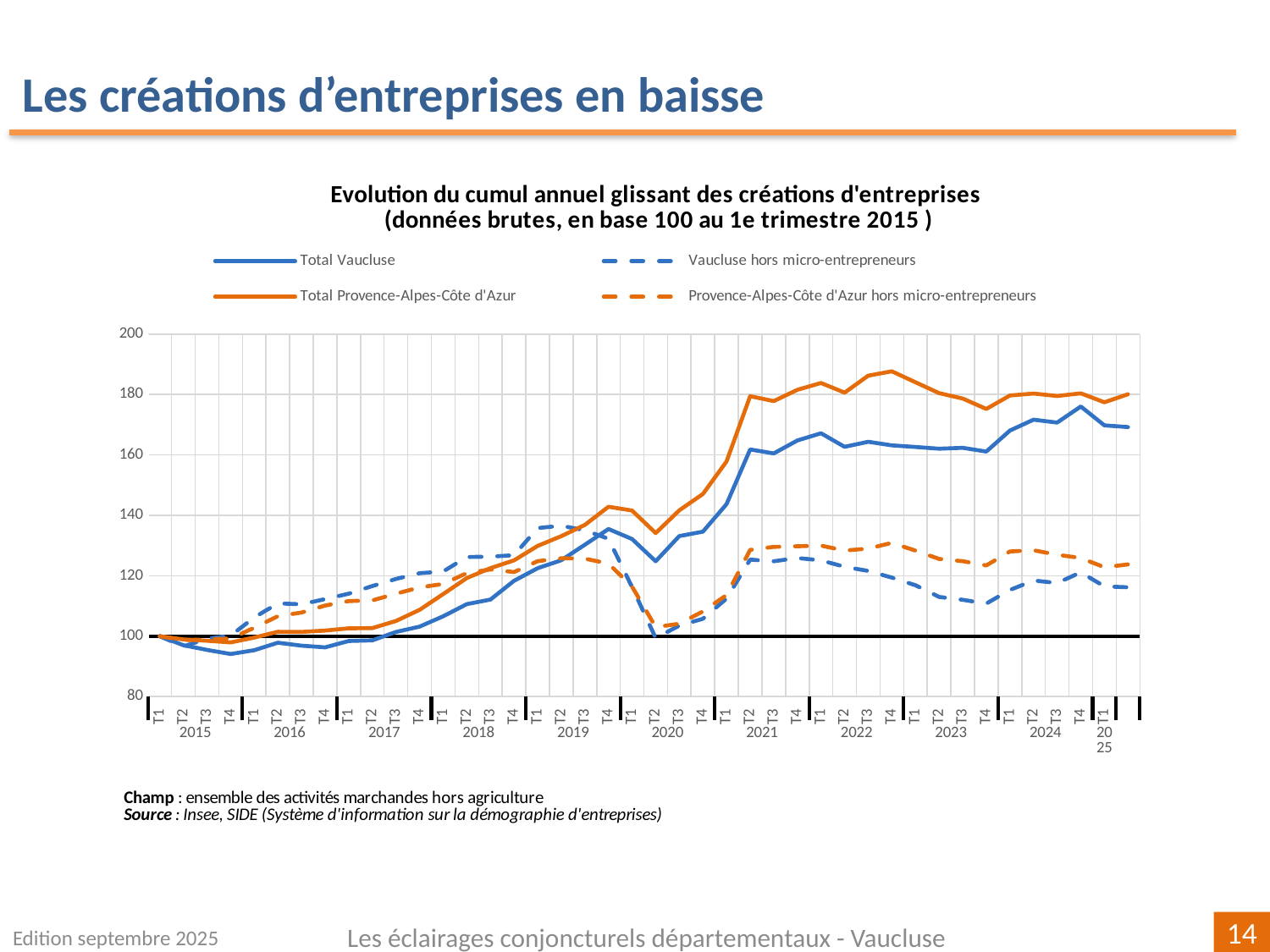
Does the Total Vaucluse series rise or fall overall from T1 2015 to T1 2025? Rise At T1 2025, which is higher: Total Vaucluse or Total Provence-Alpes-Côte d'Azur? Total Provence-Alpes-Côte d'Azur Is the value for Provence-Alpes-Côte d'Azur hors micro-entrepreneurs at T1 2025 greater or less than 140? less Is the value for Vaucluse hors micro-entrepreneurs at T2 2020 greater or less than 120? less Is the value for Total Provence-Alpes-Côte d'Azur at T4 2022 greater or less than 180? greater What is the value of all series at T1 2015, the base quarter? 100 Which colour is used for the two Vaucluse series? Blue How many series does the legend list? 4 What is the title of the chart? Evolution du cumul annuel glissant des créations d'entreprises (données brutes, en base 100 au 1e trimestre 2015 ) What kind of chart is shown on the slide? Line chart